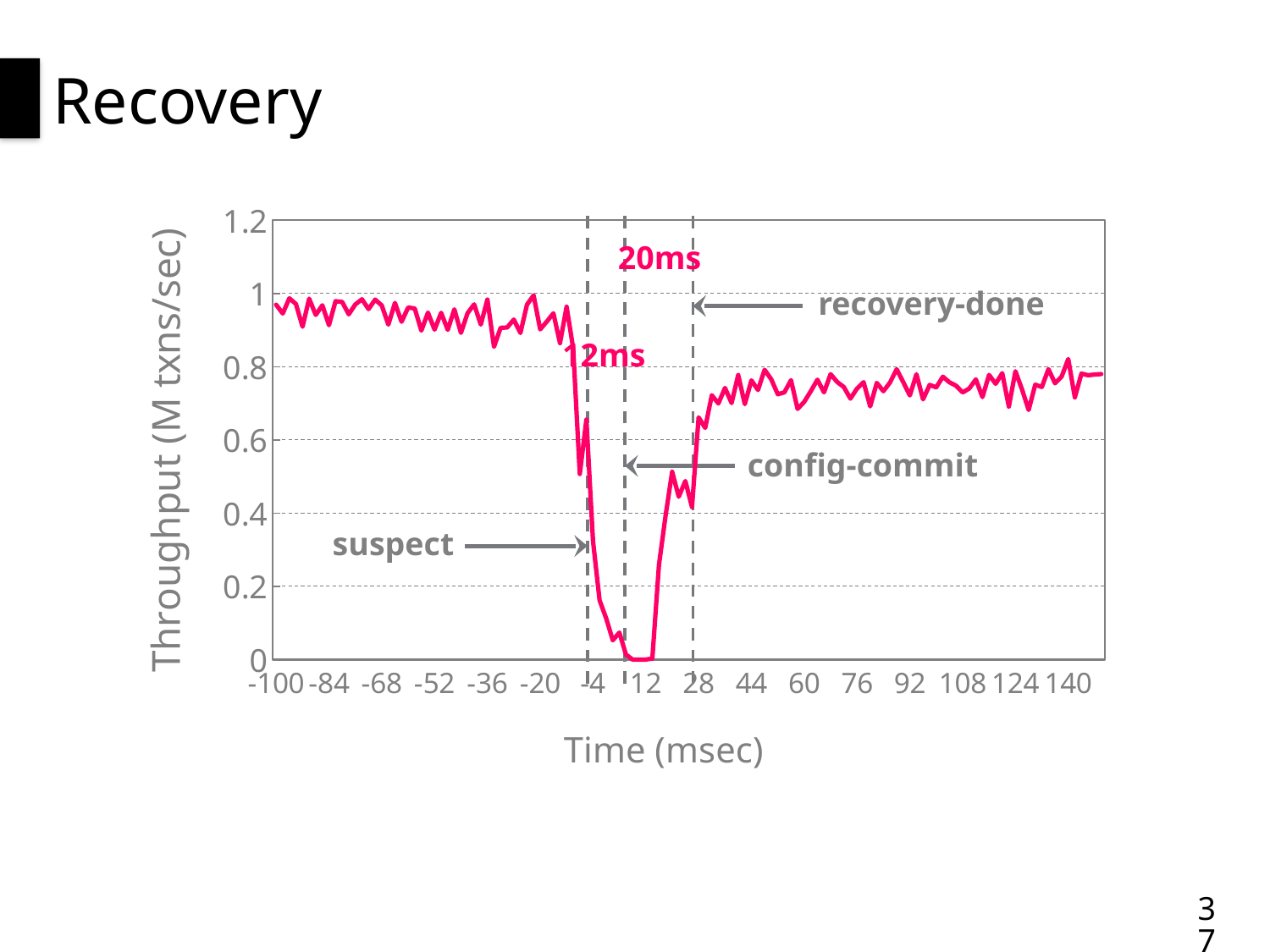
What kind of chart is shown on the slide? line chart Is the throughput higher at time -52 msec or at time 92 msec? -52 msec Is the throughput at time 92 msec greater or less than 1? less What is the label of the x axis? Time (msec) Is the throughput at time -100 msec greater or less than 0.8? greater How does the throughput change between time -4 msec and time 12 msec? it falls Is the throughput at time 60 msec greater or less than 0.6? greater What is the label of the y axis? Throughput (M txns/sec) According to the annotation, how much time elapses between the config-commit line and the recovery-done line? 20ms According to the annotation, how much time elapses between the suspect line and the config-commit line? 12ms Which event is marked by the first (leftmost) dashed vertical line? suspect